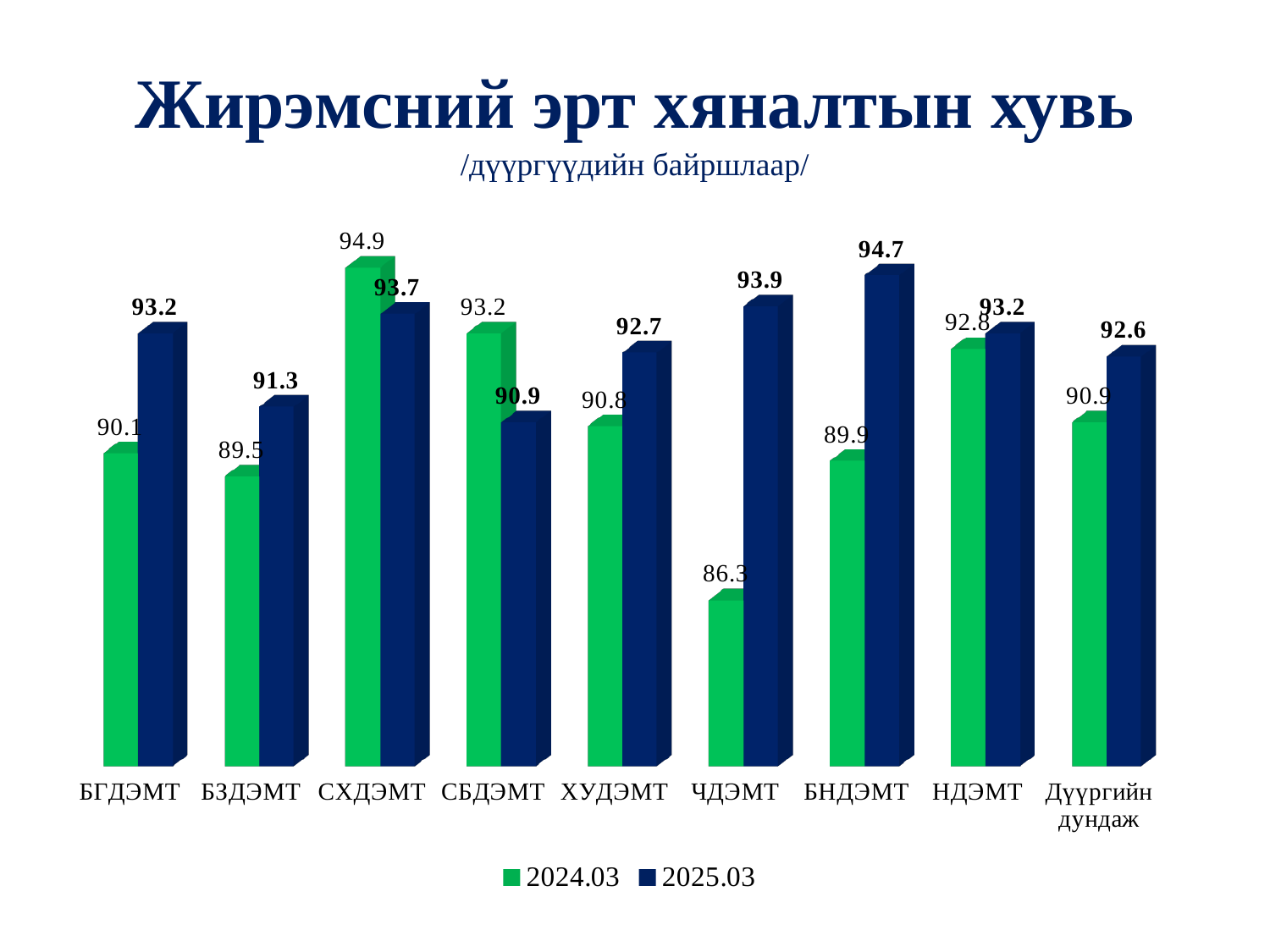
What is the 2025.03 value for Дүүргийн дундаж? 92.6 Which is larger for СБДЭМТ, the 2024.03 value or the 2025.03 value? 2024.03 Which category has the highest 2025.03 value? БНДЭМТ What is the 2024.03 value for СХДЭМТ? 94.9 What is the 2024.03 value for БНДЭМТ? 89.9 Which category has the lowest 2024.03 value? ЧДЭМТ Which colour represents the 2025.03 series? Dark blue How many categories are shown on the x axis? 9 What kind of chart is shown on the slide? Bar chart How many series does the legend list? 2 What is the difference between the 2025.03 and 2024.03 values for ЧДЭМТ? 7.6 What is the 2025.03 value for ЧДЭМТ? 93.9